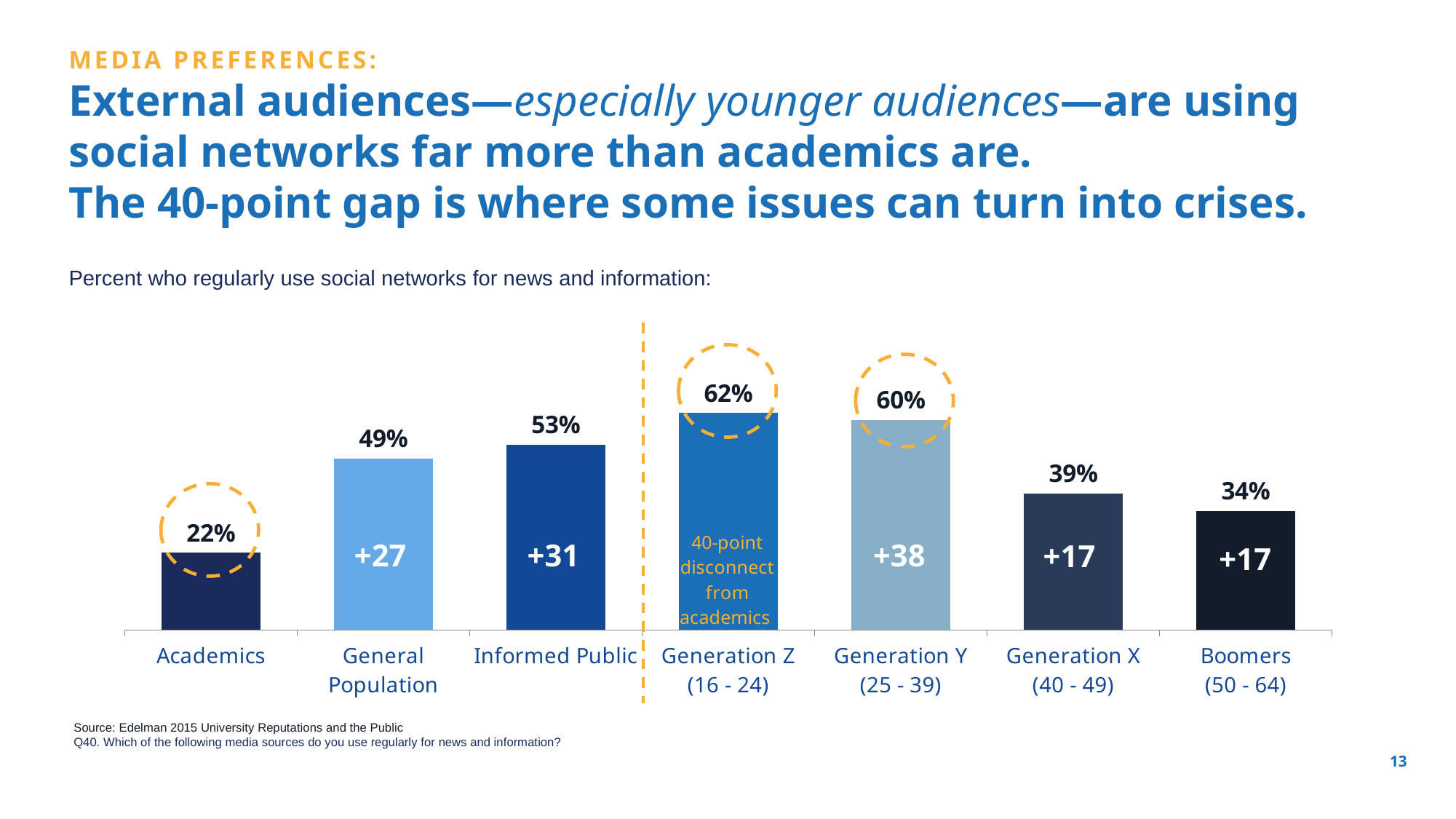
What is the difference between the values for Generation Y and Generation X? 21 percentage points What is the value shown for Generation Z (16 - 24)? 62% What is the value shown for Boomers (50 - 64)? 34% What is the value shown for Informed Public? 53% Which category has the highest value? Generation Z (16 - 24) What percent of Academics regularly use social networks for news and information? 22% What gap relative to Academics is printed inside the Generation Y bar? +38 How many categories are shown in the chart? 7 What is the difference between the values for Generation Z and Academics? 40 percentage points Which is larger, the value for General Population or the value for Generation X? General Population What kind of chart is shown on the slide? Bar chart Which category has the lowest value? Academics